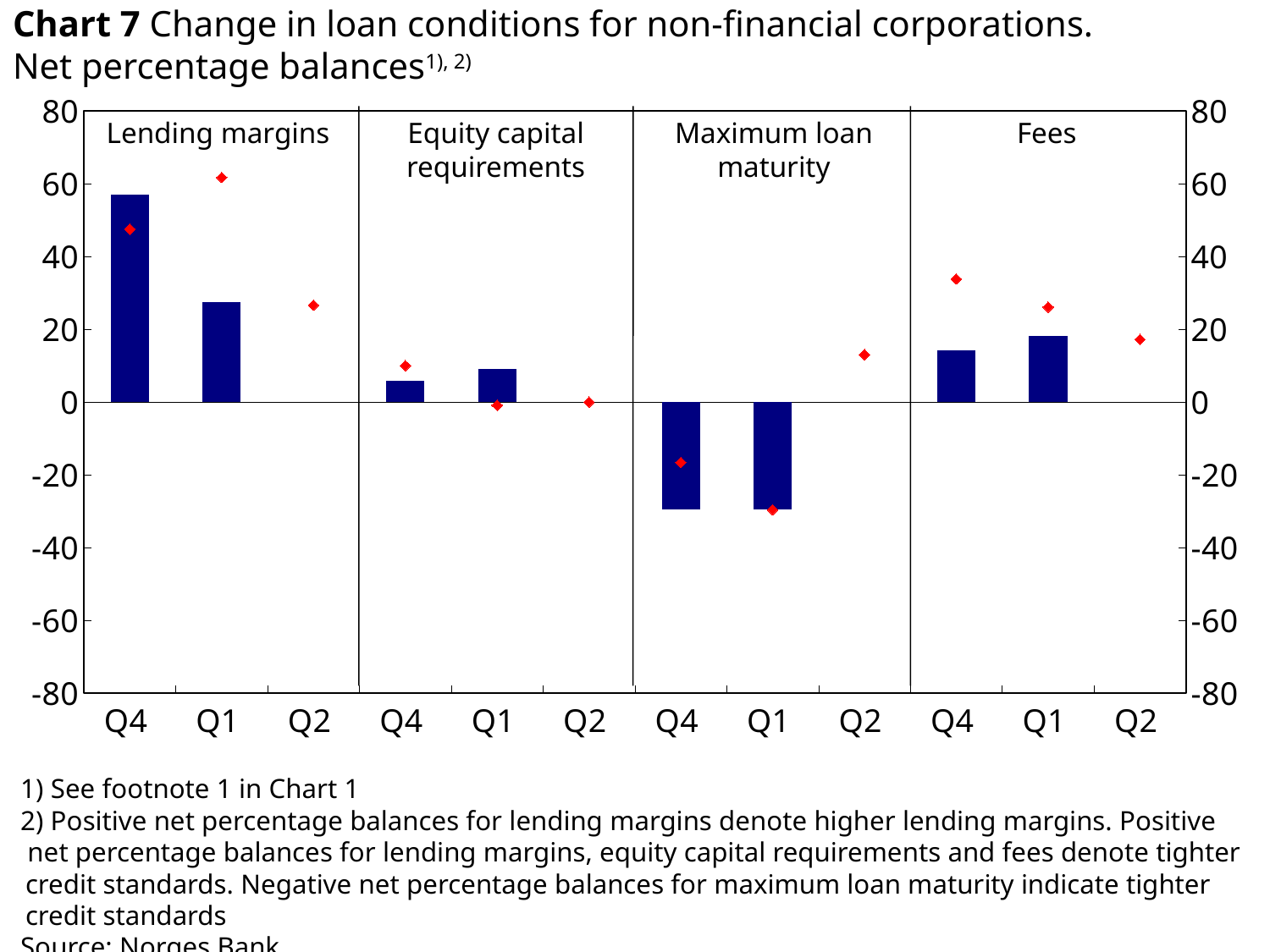
Is the Q1 bar for Fees greater or less than 10? greater Is the Q1 bar for Lending margins greater or less than 20? greater Which is larger for Equity capital requirements, the Q4 bar or the Q1 bar? Q1 Is the Q4 bar for Lending margins greater or less than 40? greater What is the range of the vertical axis? -80 to 80 Which panel contains the tallest bar in the chart? Lending margins What kind of chart is Chart 7? combination bar and line chart Which is larger for Lending margins, the Q4 bar or the Q1 bar? Q4 How many quarters are shown on the x axis within each panel? 3 Which panel has bars with negative values? Maximum loan maturity How many loan condition panels are shown in the chart? 4